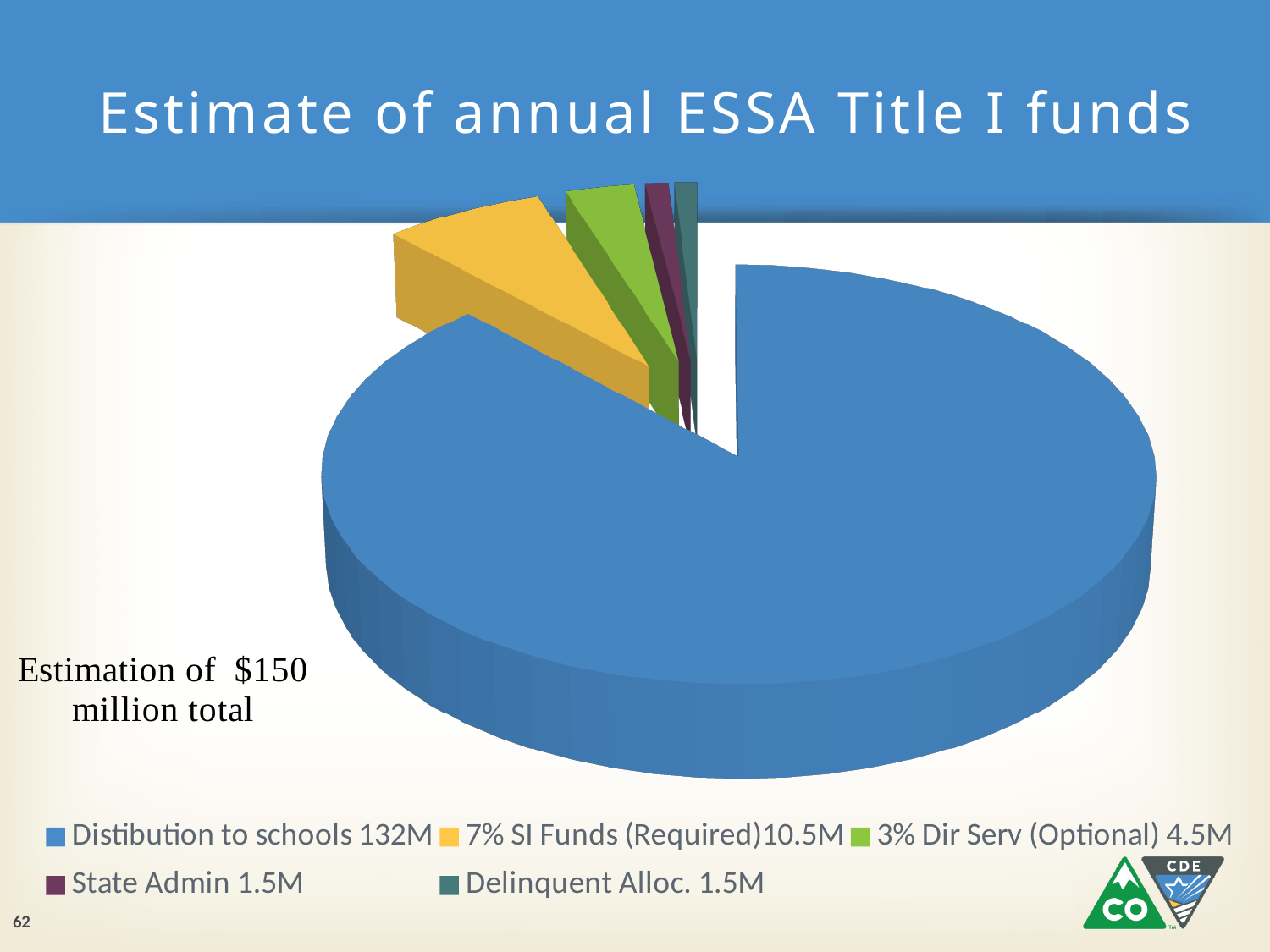
What share of the $150 million total is the Distibution to schools slice? 88% What is the difference between the 7% SI Funds (Required) value and the 3% Dir Serv (Optional) value? 6M How many slices does the pie chart have? 5 Which is larger, 7% SI Funds (Required) or 3% Dir Serv (Optional)? 7% SI Funds (Required) What kind of chart is shown on the slide? pie chart What colour is the Distibution to schools slice? blue What is the title of the chart on the slide? Estimate of annual ESSA Title I funds What value is given in the legend for 3% Dir Serv (Optional)? 4.5M What value is given in the legend for State Admin? 1.5M Which category has the largest slice of the pie? Distibution to schools 132M What value is given in the legend for 7% SI Funds (Required)? 10.5M What value is given in the legend for Distibution to schools? 132M